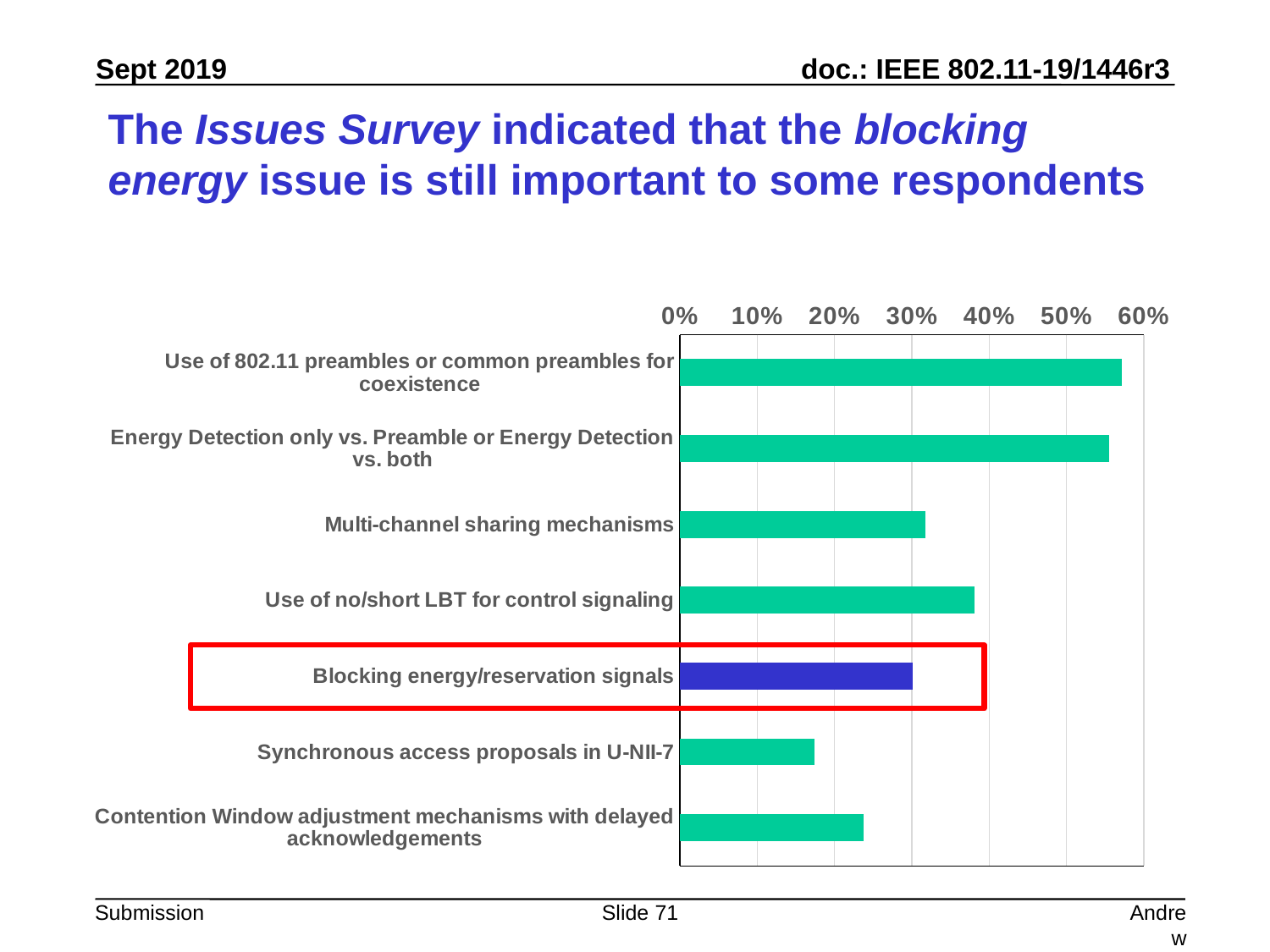
How many categories are plotted in the chart? 7 Is the value for Multi-channel sharing mechanisms greater or less than 30%? greater Which category's bar is shown in a different colour and outlined with a red box? Blocking energy/reservation signals Is the value for Use of no/short LBT for control signaling greater or less than 40%? less Is the value for Synchronous access proposals in U-NII-7 greater or less than 20%? less Which category has the highest value in the chart? Use of 802.11 preambles or common preambles for coexistence Which category has the lowest value in the chart? Synchronous access proposals in U-NII-7 Which is larger: the value for Use of no/short LBT for control signaling or the value for Multi-channel sharing mechanisms? Use of no/short LBT for control signaling Which is larger: the value for Contention Window adjustment mechanisms with delayed acknowledgements or the value for Synchronous access proposals in U-NII-7? Contention Window adjustment mechanisms with delayed acknowledgements What kind of chart is shown on the slide? bar chart